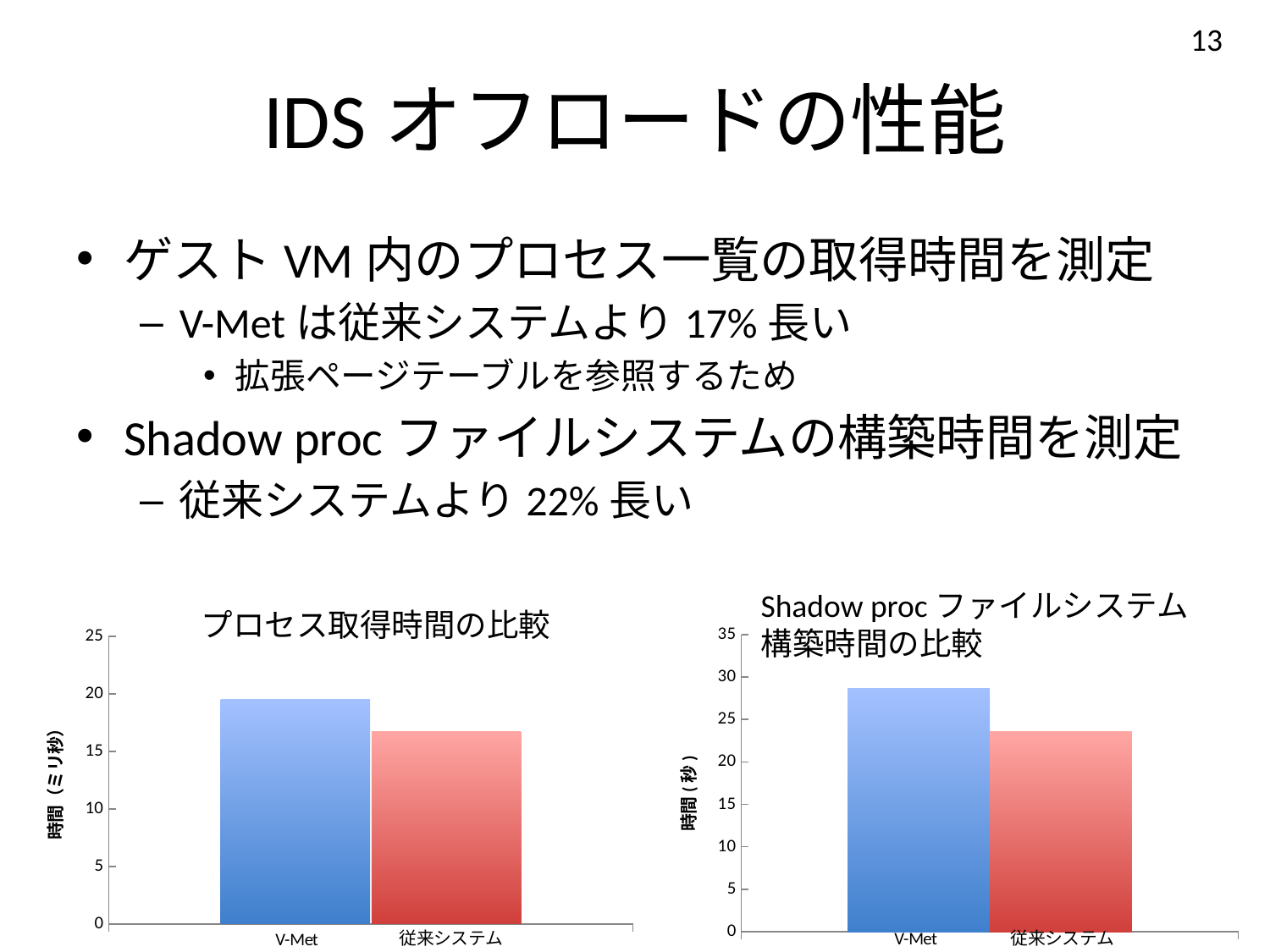
In the right chart (Shadow proc ファイルシステム構築時間の比較), is the value for 従来システム greater or less than 25? less In the right chart (Shadow proc ファイルシステム構築時間の比較), which category has the lowest value? 従来システム In the left chart (プロセス取得時間の比較), which category has the lowest value? 従来システム In the right chart (Shadow proc ファイルシステム構築時間の比較), is the value for V-Met greater or less than 25? greater In the left chart (プロセス取得時間の比較), is the value for V-Met greater or less than 15? greater In the left chart (プロセス取得時間の比較), which category has the highest value? V-Met What kind of chart is the left chart titled プロセス取得時間の比較? bar chart What is the y-axis label of the left chart (プロセス取得時間の比較)? 時間（ミリ秒） What is the y-axis label of the right chart (Shadow proc ファイルシステム構築時間の比較)? 時間(秒) In the right chart (Shadow proc ファイルシステム構築時間の比較), which is larger, the value for V-Met or the value for 従来システム? V-Met In the left chart (プロセス取得時間の比較), how many categories are shown on the x axis? 2